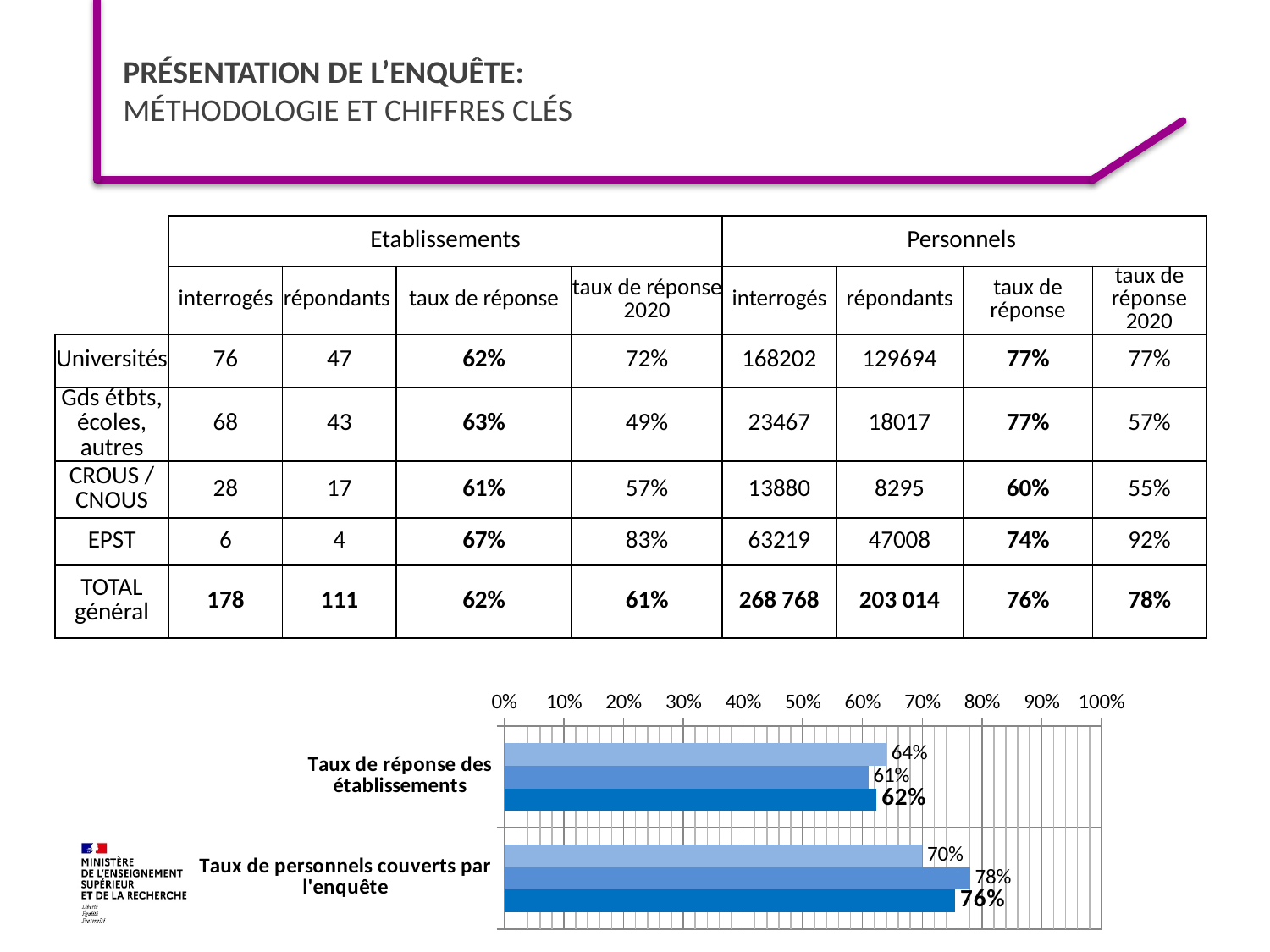
In the bar chart, is the bottom bar for 'Taux de personnels couverts par l'enquête' larger or smaller than the bottom bar for 'Taux de réponse des établissements'? larger In the bar chart, which of the three bars for 'Taux de réponse des établissements' is the longest? the top (lightest blue) bar, 64% In the bar chart, what is the value of the bottom (darkest blue) bar for 'Taux de réponse des établissements'? 62% In the bar chart, which of the three bars for 'Taux de personnels couverts par l'enquête' is the shortest? the top (lightest blue) bar, 70% In the bar chart, what is the difference between the middle bar (78%) and the top bar (70%) for 'Taux de personnels couverts par l'enquête'? 8 percentage points In the bar chart, what is the value of the top (lightest blue) bar for 'Taux de réponse des établissements'? 64% What kind of chart is shown at the bottom of the slide? bar chart In the bar chart, what is the value of the bottom (darkest blue) bar for 'Taux de personnels couverts par l'enquête'? 76% How many categories does the bar chart show? 2 What is the maximum value shown on the bar chart's horizontal axis? 100% How many bars are plotted for each category in the bar chart? 3 In the bar chart, what is the value of the middle bar for 'Taux de personnels couverts par l'enquête'? 78%